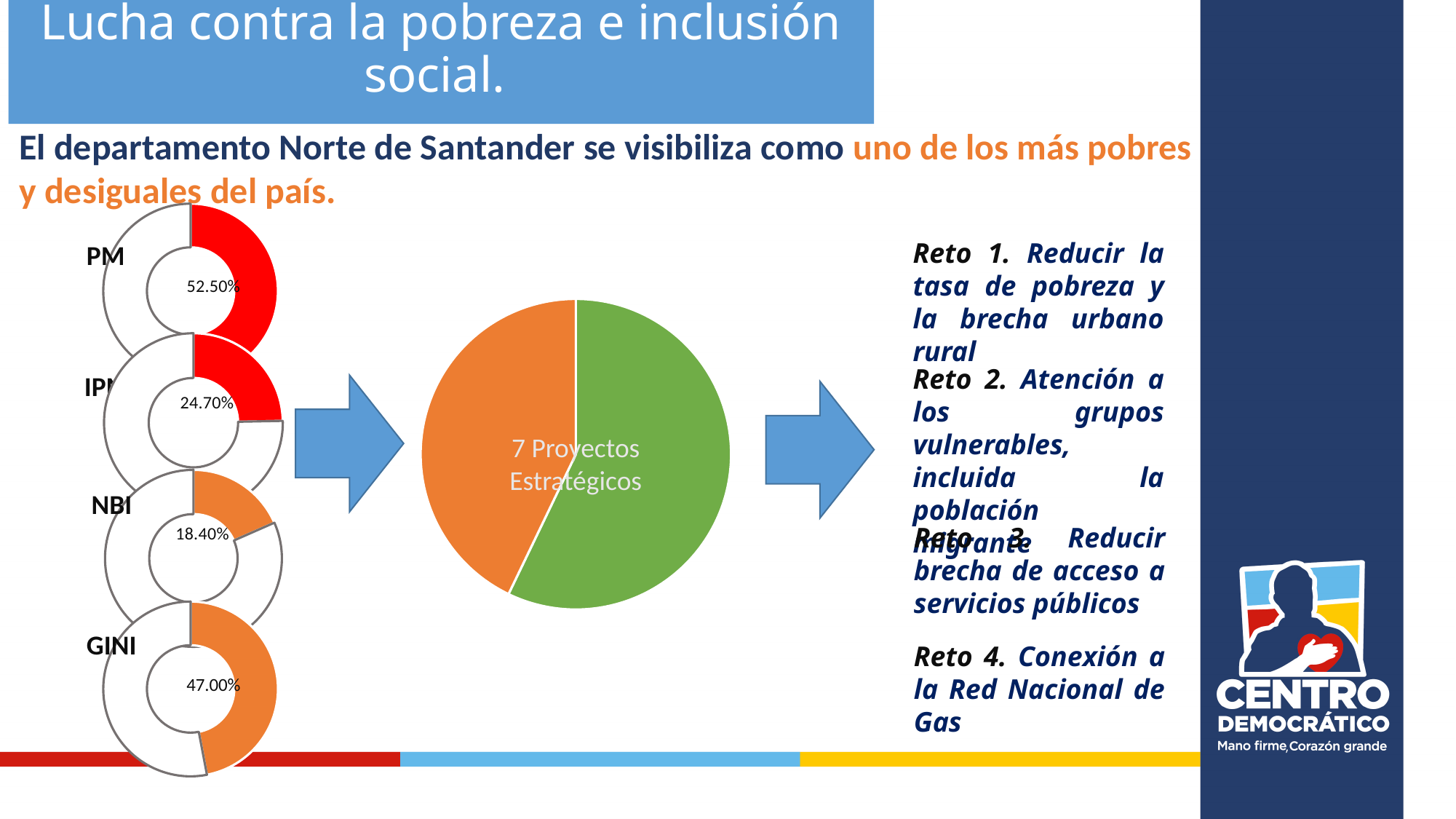
How many slices does the pie chart in the centre of the slide have? 2 In the donut charts on the left, what is the difference between the PM value and the GINI value? 5.50% What kind of chart is the orange and green chart in the centre of the slide? Pie chart Among the four donut charts on the left (PM, IPM, NBI, GINI), which indicator has the lowest value? NBI In the PM donut chart on the left, what value is shown? 52.50% In the NBI donut chart on the left, what value is shown? 18.40% In the donut charts on the left, which is larger, the IPM value or the NBI value? IPM How many donut charts are shown on the left side of the slide? 4 In the GINI donut chart on the left, what value is shown? 47.00% In the IPM donut chart on the left, what value is shown? 24.70% Among the four donut charts on the left (PM, IPM, NBI, GINI), which indicator has the highest value? PM What text is written in the centre of the pie chart in the middle of the slide? 7 Proyectos Estratégicos